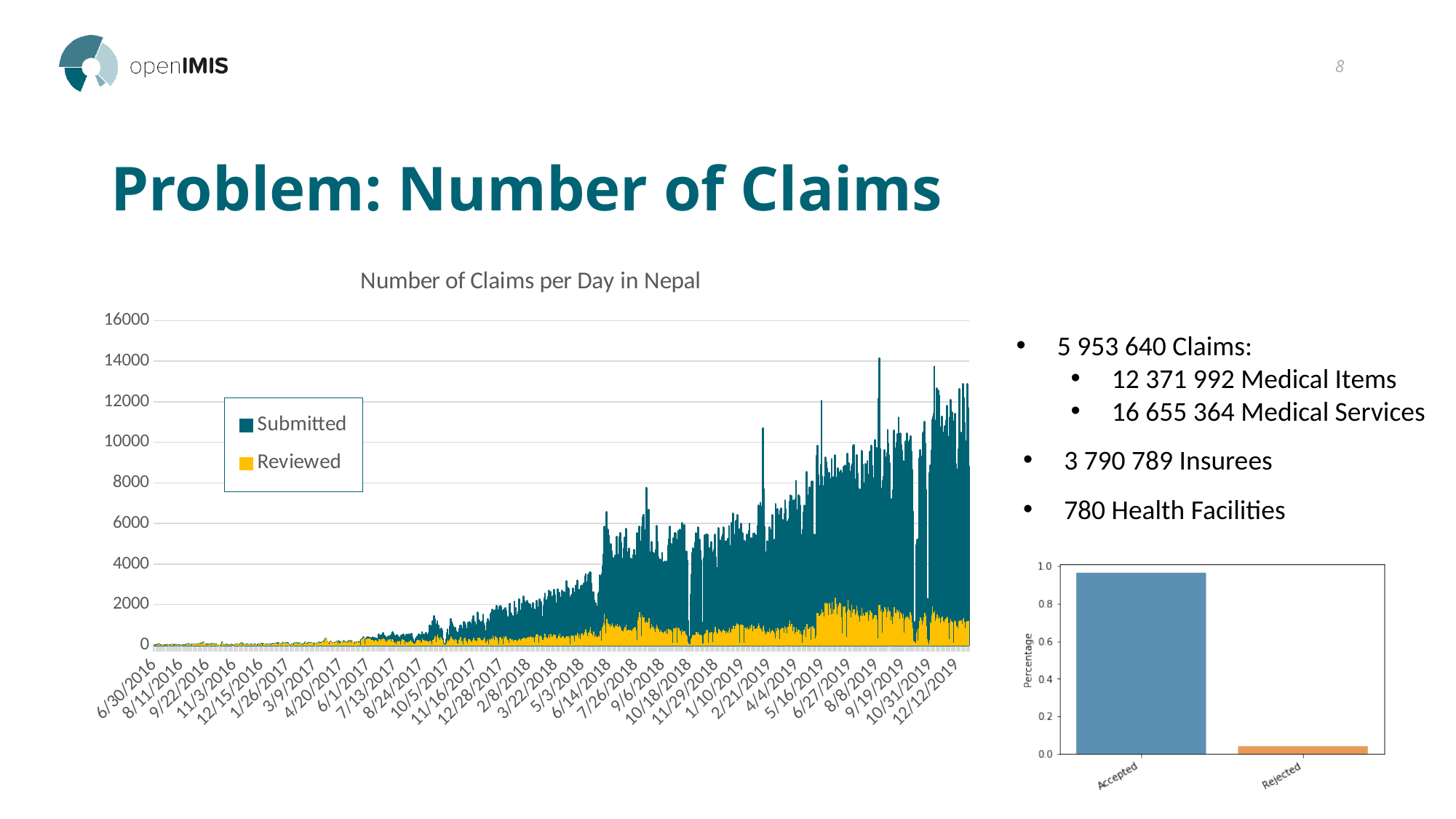
What kind of chart is the small chart at the bottom right of the slide? bar chart On the small bar chart at the bottom right, is the value for Accepted greater or less than 0.8? greater On the chart titled 'Number of Claims per Day in Nepal', which series has the larger values, Submitted or Reviewed? Submitted On the chart titled 'Number of Claims per Day in Nepal', what are the two series named in the legend? Submitted and Reviewed On the chart titled 'Number of Claims per Day in Nepal', what is the highest value shown on the vertical axis? 16000 On the chart titled 'Number of Claims per Day in Nepal', are the Reviewed values greater or less than 4000 throughout the period? less On the small bar chart at the bottom right, is the value for Rejected greater or less than 0.2? less On the small bar chart at the bottom right, which category has the lowest value? Rejected How many categories are shown on the small bar chart at the bottom right of the slide? 2 On the chart titled 'Number of Claims per Day in Nepal', how many series does the legend list? 2 On the small bar chart at the bottom right, which category has the highest value? Accepted On the chart titled 'Number of Claims per Day in Nepal', do the Submitted values generally rise or fall from 2016 to 2019? rise